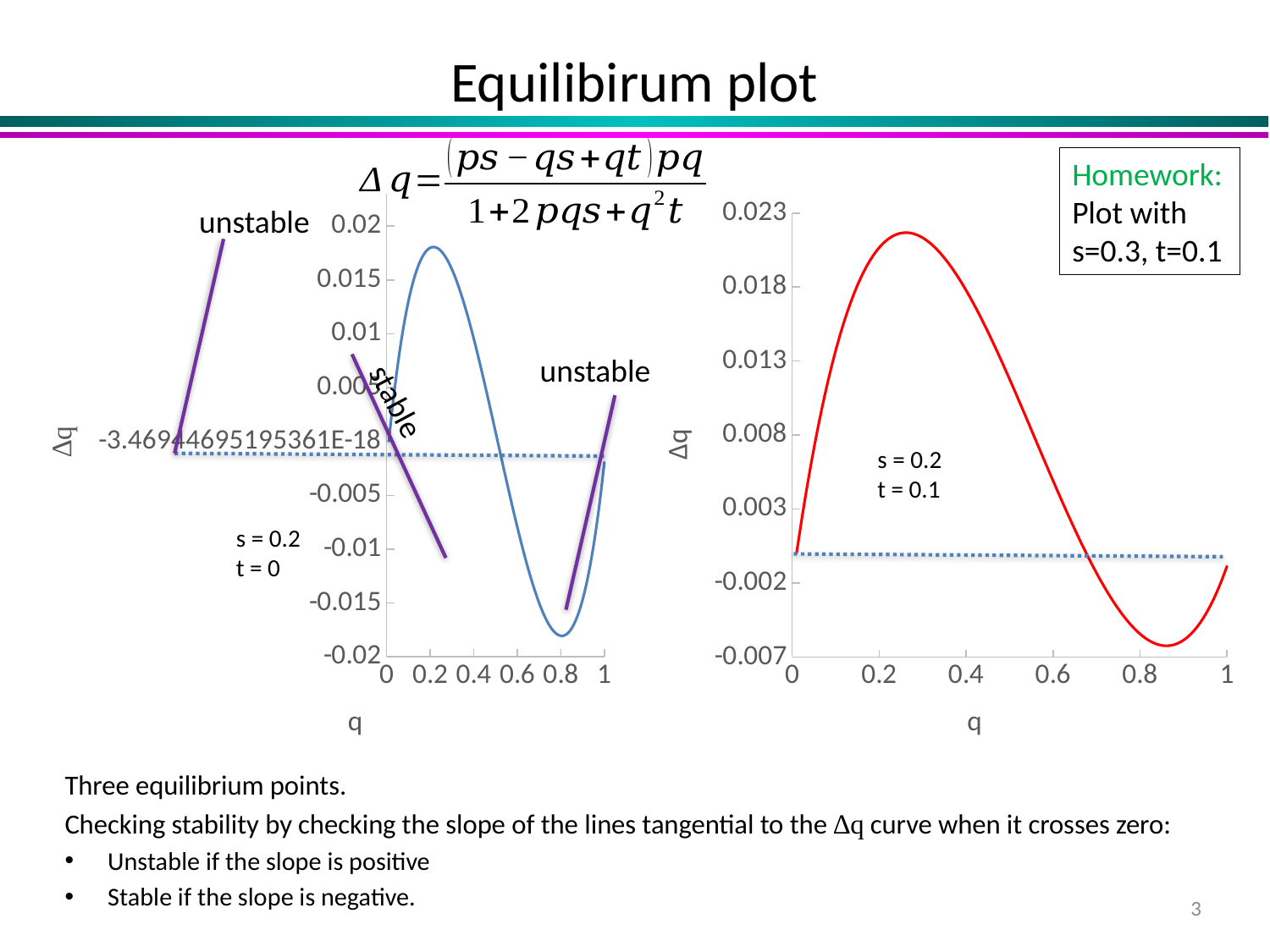
What is the label of the x axis on the right chart (s = 0.2, t = 0.1)? q What colour is the curve on the right chart (s = 0.2, t = 0.1)? red What kind of chart is the left chart (s = 0.2, t = 0)? line chart On the left chart (s = 0.2, t = 0), is the value of Δq at q = 0.8 greater or less than -0.015? less On the right chart (s = 0.2, t = 0.1), does Δq rise or fall as q goes from 0 to 0.2? rise On the left chart (s = 0.2, t = 0), is Δq larger at q = 0.2 or at q = 0.8? q = 0.2 What kind of chart is the right chart (s = 0.2, t = 0.1)? line chart On the left chart (s = 0.2, t = 0), is the value of Δq at q = 0.2 greater or less than 0.015? greater On the left chart (s = 0.2, t = 0), does Δq rise or fall as q goes from 0.2 to 0.8? fall On the right chart (s = 0.2, t = 0.1), is the value of Δq at q = 0.2 greater or less than 0.018? greater On the right chart (s = 0.2, t = 0.1), is Δq larger at q = 0.2 or at q = 0.8? q = 0.2